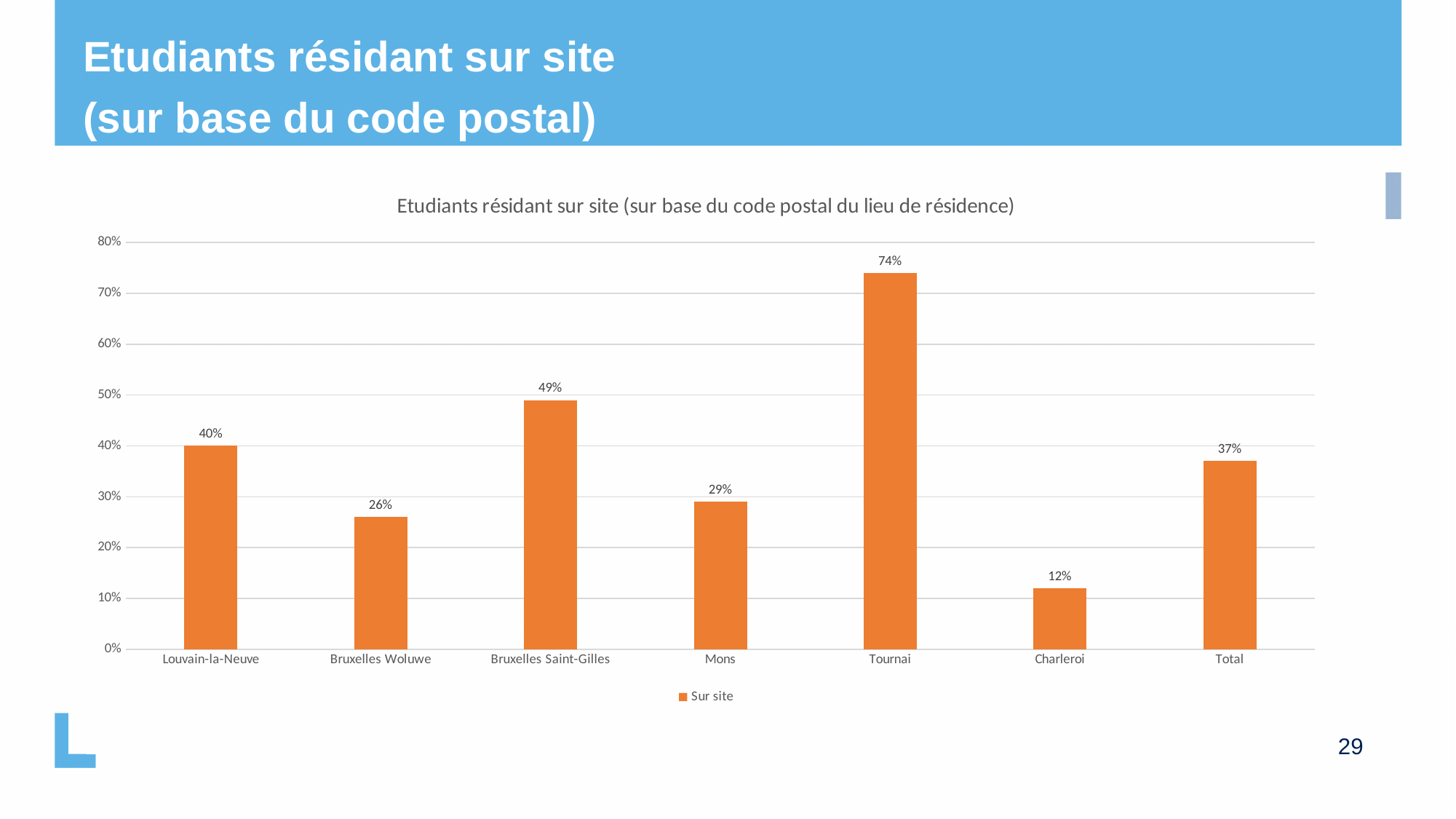
Which category has the lowest value? Charleroi Is the value for Louvain-la-Neuve greater or less than 30%? greater How many categories are shown on the x axis? 7 What series name does the legend show? Sur site What is the difference between the values for Tournai and Charleroi? 62% What kind of chart is shown? bar chart Which is larger, the value for Mons or the value for Bruxelles Woluwe? Mons Which category has the highest value? Tournai What is the value for Tournai? 74% What is the value for Total? 37% What is the difference between the values for Bruxelles Saint-Gilles and Louvain-la-Neuve? 9% What is the value for Bruxelles Woluwe? 26%